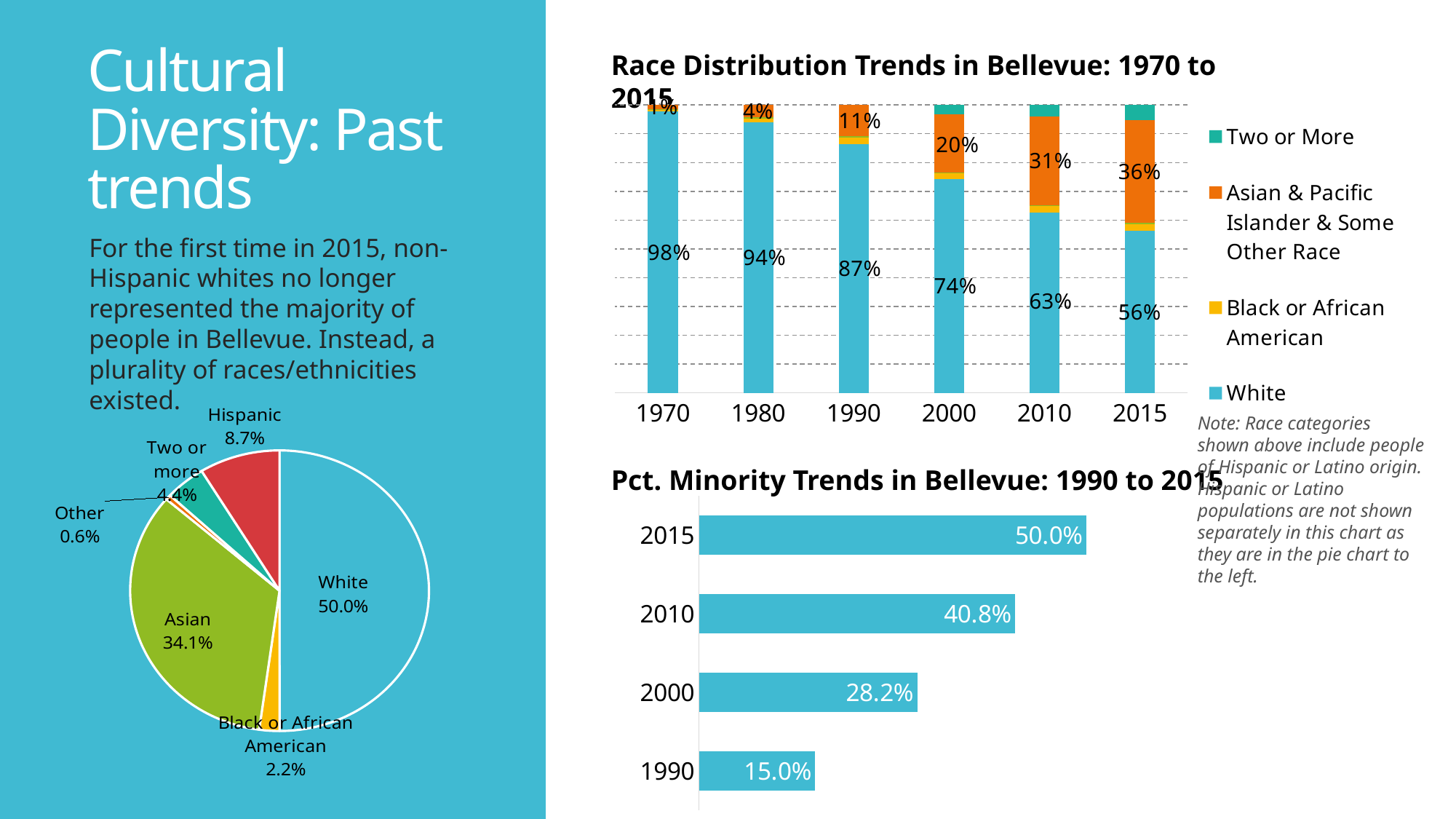
In the 'Pct. Minority Trends in Bellevue: 1990 to 2015' chart, what is the value for 1990? 15.0% In the 'Pct. Minority Trends in Bellevue: 1990 to 2015' chart, do the values rise or fall from 1990 to 2015? rise In the 'Race Distribution Trends in Bellevue: 1970 to 2015' chart, what is the Asian & Pacific Islander & Some Other Race share in 2015? 36% In the 'Race Distribution Trends in Bellevue: 1970 to 2015' chart, which year has the lowest White share? 2015 In the pie chart on the left, which slice is the smallest? Other In the 'Pct. Minority Trends in Bellevue: 1990 to 2015' chart, how many years are shown? 4 In the 'Pct. Minority Trends in Bellevue: 1990 to 2015' chart, what is the value for 2015? 50.0% In the pie chart on the left, which is larger, Hispanic or Two or more? Hispanic In the 'Pct. Minority Trends in Bellevue: 1990 to 2015' chart, what is the difference between the 2010 and 2000 values? 12.6% In the pie chart on the left, what share does Asian have? 34.1% In the 'Race Distribution Trends in Bellevue: 1970 to 2015' chart, how many series does the legend list? 4 In the 'Race Distribution Trends in Bellevue: 1970 to 2015' chart, what is the White share in 1990? 87%